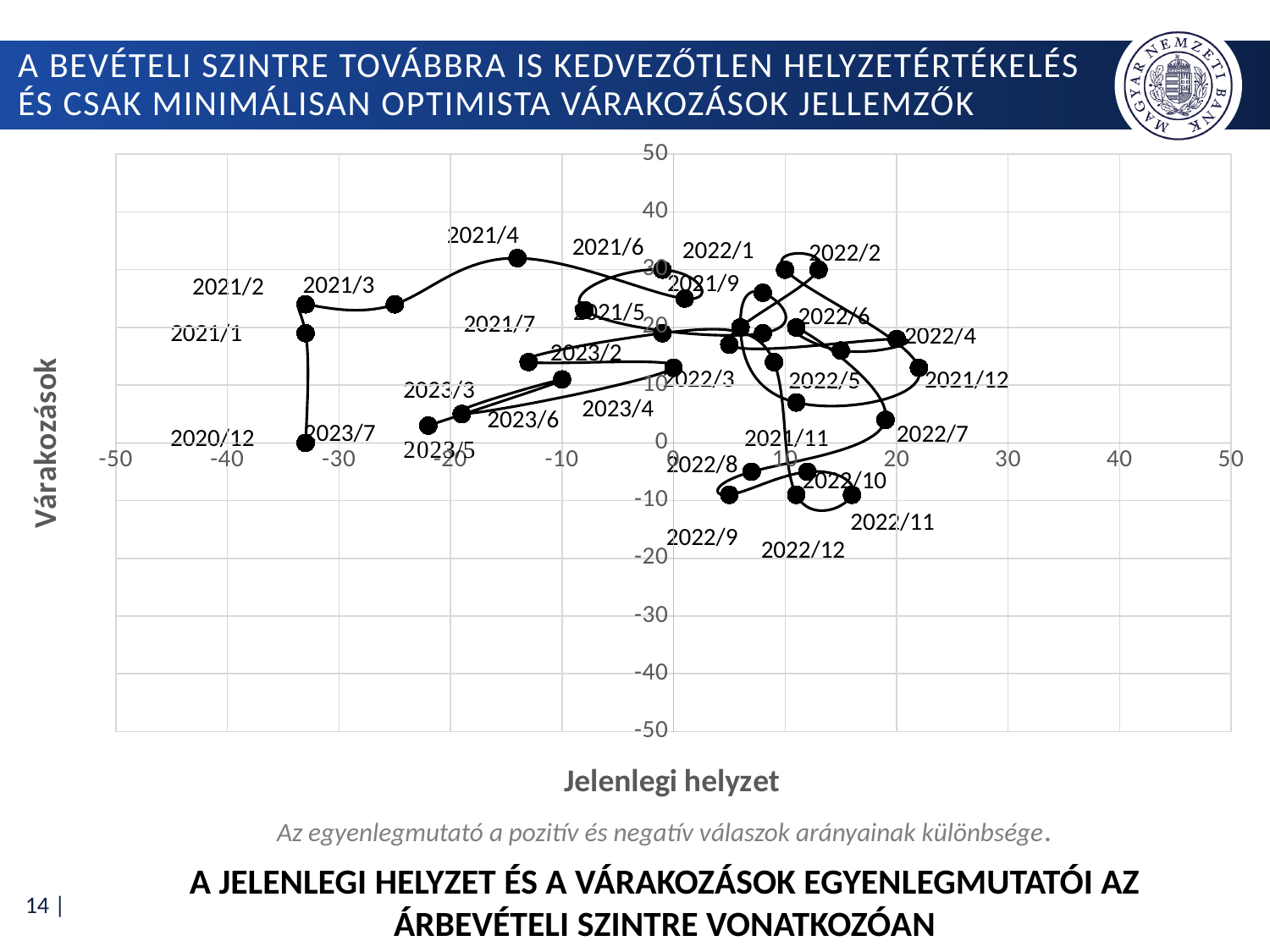
Is the Jelenlegi helyzet (horizontal) value for 2020/12 greater or less than -30? less What kind of chart is shown on the slide? scatter chart Is the Jelenlegi helyzet (horizontal) value for 2022/4 greater or less than 10? greater Is the Várakozások (vertical) value for 2022/2 greater or less than 20? greater Which point has the lower Várakozások (vertical) value, 2022/12 or 2022/6? 2022/12 What is the title of the horizontal axis of the chart? Jelenlegi helyzet What is the title of the vertical axis of the chart? Várakozások Which point has the higher Jelenlegi helyzet (horizontal) value, 2022/4 or 2021/2? 2022/4 Which point has the higher Várakozások (vertical) value, 2021/4 or 2023/7? 2021/4